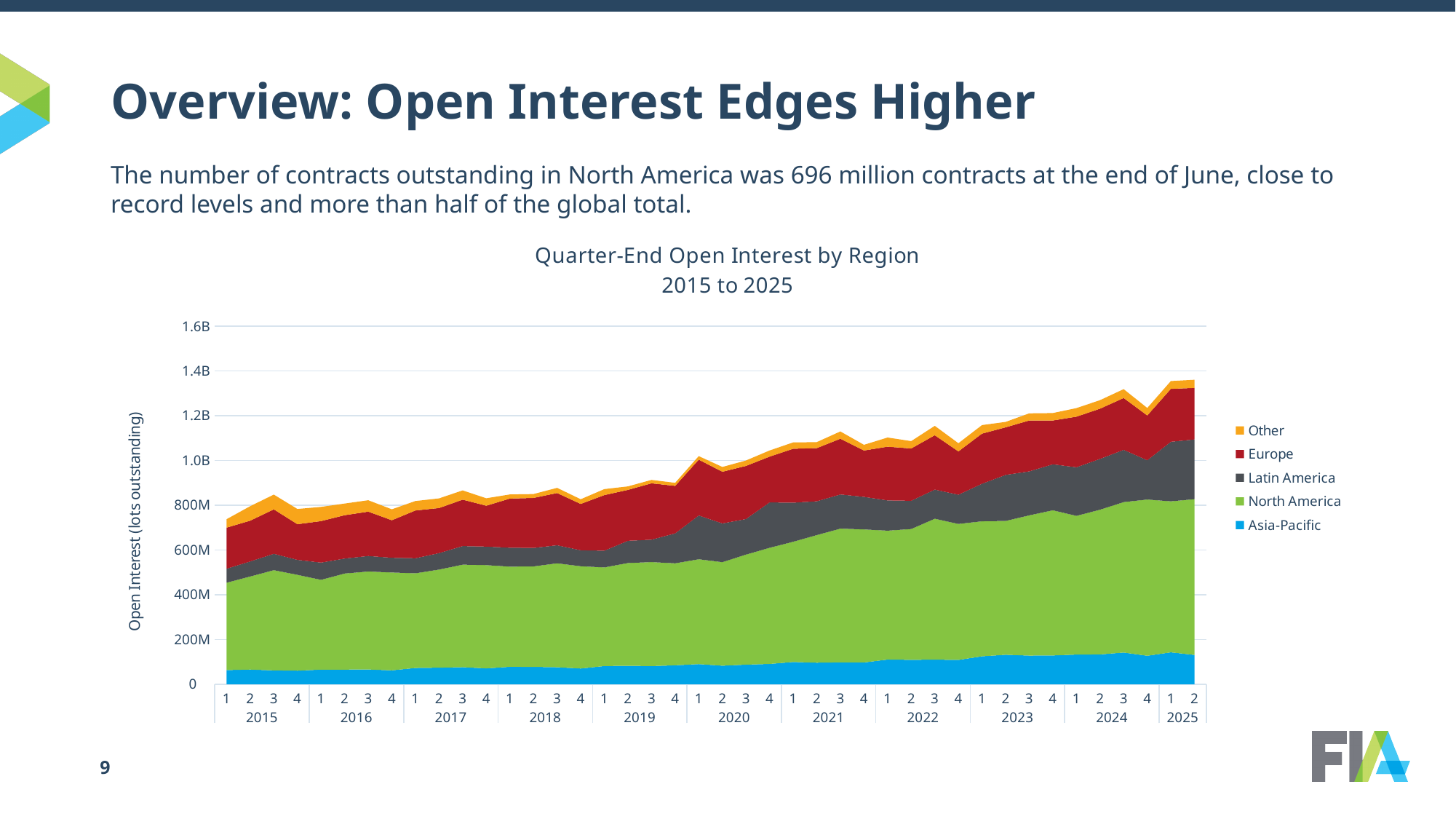
How many years are labelled along the x axis? 11 What kind of chart is shown on the slide? Stacked area chart What is the title of the chart? Quarter-End Open Interest by Region 2015 to 2025 Which is larger, total open interest in Q2 2025 or in Q1 2015? Q2 2025 Is the total open interest in Q1 2015 greater or less than 800M? less Does total open interest generally rise or fall from 2015 to 2025? Rise How many series does the legend list? 5 Which regions are listed in the chart legend? Other, Europe, Latin America, North America, Asia-Pacific Which region accounts for the largest share of open interest throughout the chart? North America Is the total open interest in Q2 2025 greater or less than 1.2B? greater Is the Asia-Pacific open interest in Q2 2025 greater or less than 200M? less